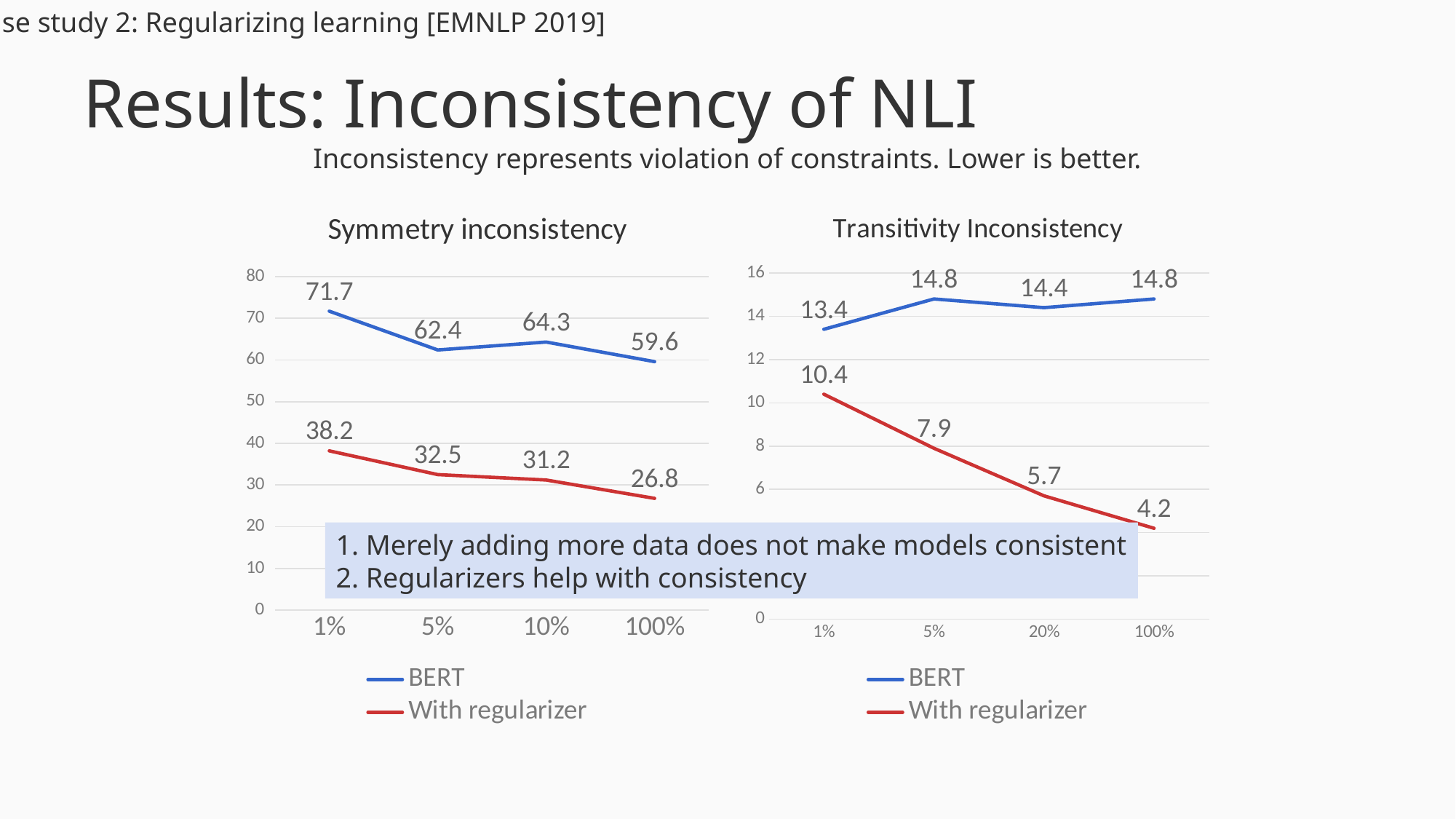
What type of chart is the Symmetry inconsistency chart? Line chart In the Symmetry inconsistency chart, what is the BERT value at 1%? 71.7 In the Symmetry inconsistency chart, at which x-axis category is the BERT value lowest? 100% In the Transitivity Inconsistency chart, which is larger at 5%: the BERT value or the With regularizer value? BERT In the Transitivity Inconsistency chart, what is the difference between the With regularizer values at 1% and 100%? 6.2 In the Transitivity Inconsistency chart, what is the BERT value at 1%? 13.4 In the Transitivity Inconsistency chart, at which x-axis category is the With regularizer value highest? 1% How many series does the legend of the Transitivity Inconsistency chart list? 2 In the Transitivity Inconsistency chart, does the With regularizer series rise or fall from 1% to 100%? Fall In the Transitivity Inconsistency chart, what is the With regularizer value at 20%? 5.7 In the Symmetry inconsistency chart, what is the difference between the BERT and With regularizer values at 5%? 29.9 In the Symmetry inconsistency chart, what is the With regularizer value at 100%? 26.8